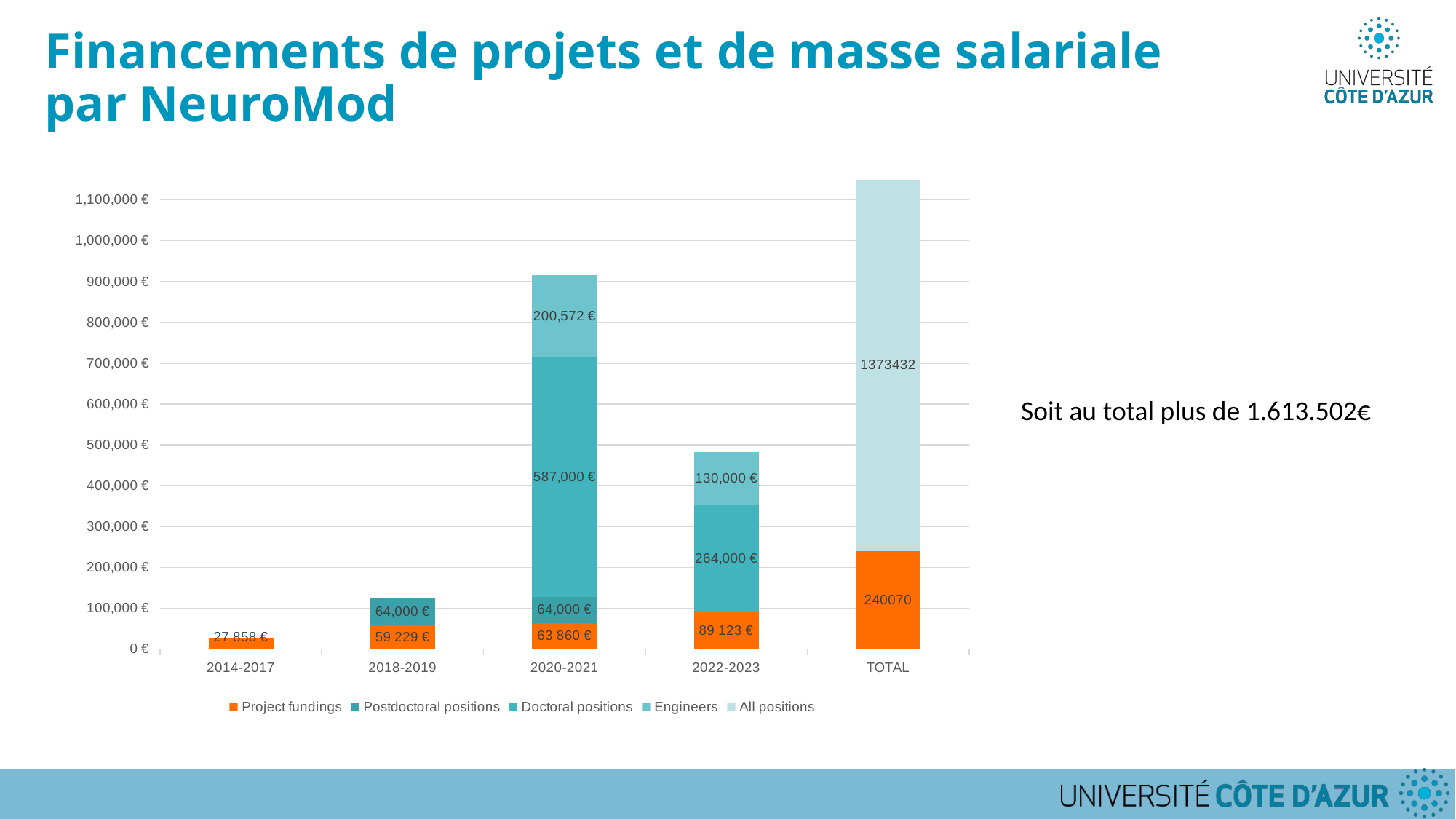
What is the value of Project fundings for 2014-2017? 27 858 € What is the value of Engineers for 2022-2023? 130,000 € Which category has the tallest stacked bar? TOTAL Is the total height of the 2020-2021 stacked bar greater or less than 800,000 €? greater Among the four period categories (excluding TOTAL), which has the lowest Project fundings value? 2014-2017 Which is larger: Project fundings for 2022-2023 or for 2020-2021? 2022-2023 How many categories are shown on the x axis? 5 How many series does the legend list? 5 What is the difference between the Engineers value for 2020-2021 and for 2022-2023? 70,572 € What is the total of the TOTAL stacked bar (Project fundings plus All positions)? 1613502 What is the value of All positions in the TOTAL bar? 1373432 What is the value of Doctoral positions for 2020-2021? 587,000 €